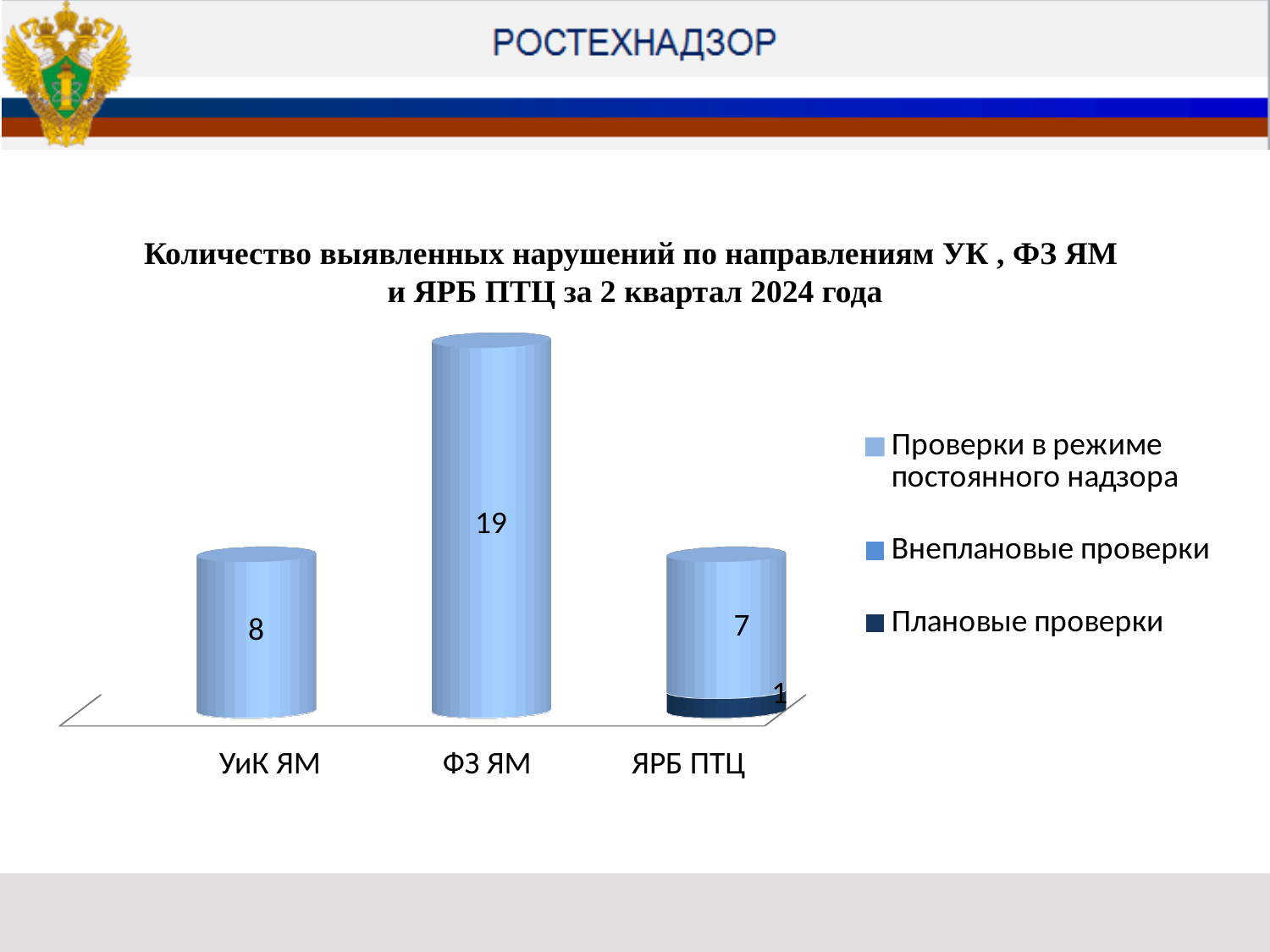
How many categories are shown on the x axis of the chart? 3 How many series does the chart legend list? 3 Which category has the highest value for Проверки в режиме постоянного надзора? ФЗ ЯМ What is the value for ФЗ ЯМ for Проверки в режиме постоянного надзора? 19 What kind of chart is shown on the slide? bar chart What is the total of the stacked bar for ЯРБ ПТЦ? 8 Which category has the lowest value for Проверки в режиме постоянного надзора? ЯРБ ПТЦ What is the value for ЯРБ ПТЦ for Плановые проверки? 1 What is the difference between the Проверки в режиме постоянного надзора values for ФЗ ЯМ and УиК ЯМ? 11 What is the value for УиК ЯМ for Проверки в режиме постоянного надзора? 8 What is the value for ЯРБ ПТЦ for Проверки в режиме постоянного надзора? 7 Which legend entry is shown in dark navy blue? Плановые проверки